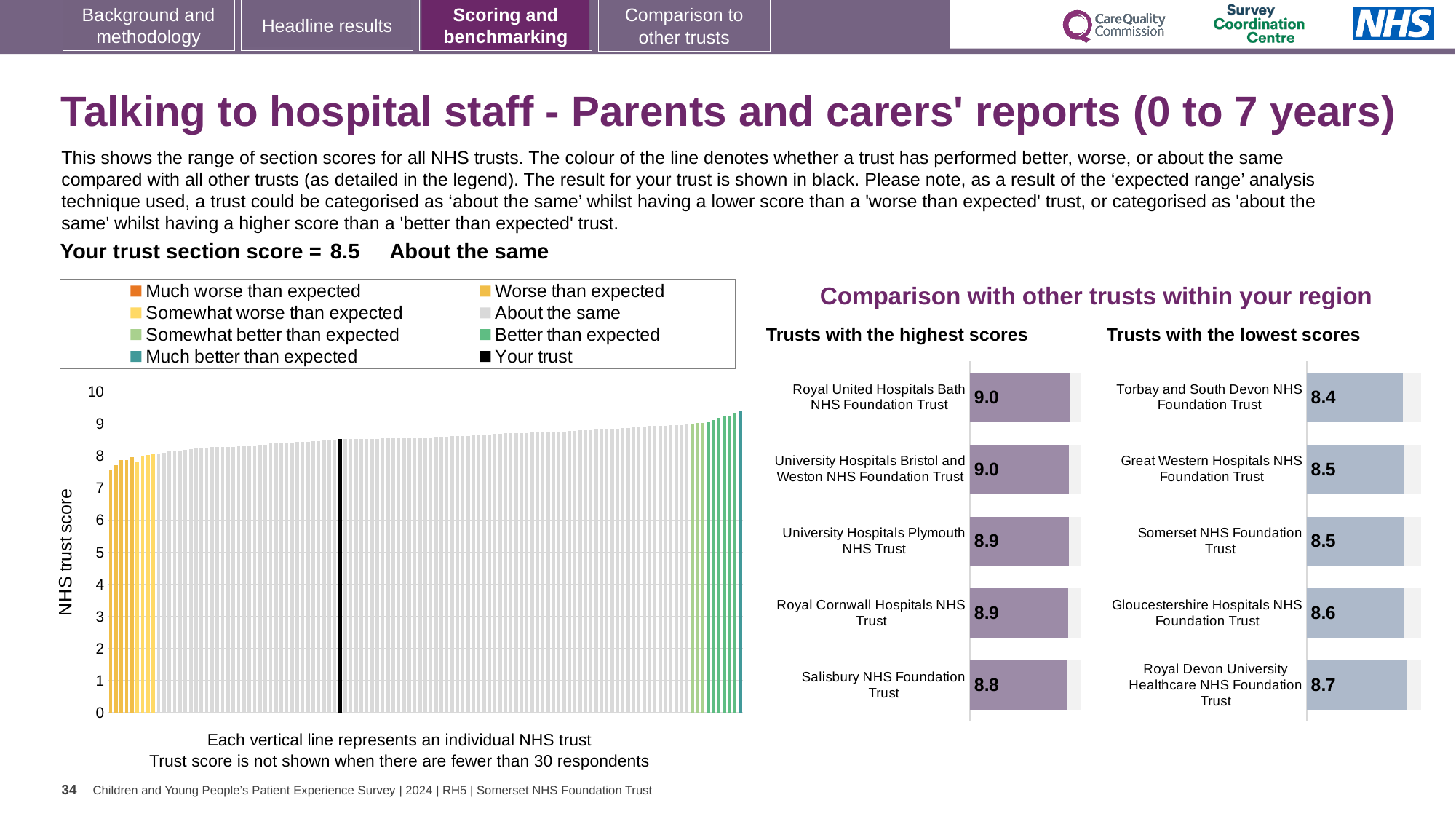
In the large chart on the left, do the trust scores rise or fall from left to right along the x axis? Rise Which is larger: the score for Salisbury NHS Foundation Trust in the highest scores chart, or the score for Royal Devon University Healthcare NHS Foundation Trust in the lowest scores chart? Salisbury NHS Foundation Trust How many entries does the legend of the large chart on the left list? 8 In the 'Trusts with the lowest scores' chart, what is the difference between the score for Royal Devon University Healthcare NHS Foundation Trust and the score for Torbay and South Devon NHS Foundation Trust? 0.3 In the 'Trusts with the lowest scores' chart, which trust has the highest score? Royal Devon University Healthcare NHS Foundation Trust How many trusts are shown in the 'Trusts with the highest scores' chart? 5 In the 'Trusts with the highest scores' chart, what is the difference between the score for Royal United Hospitals Bath NHS Foundation Trust and the score for Salisbury NHS Foundation Trust? 0.2 What kind of chart is the large chart on the left showing NHS trust scores? Bar chart In the 'Trusts with the lowest scores' chart, what is the score for Gloucestershire Hospitals NHS Foundation Trust? 8.6 In the 'Trusts with the lowest scores' chart, which trust has the lowest score? Torbay and South Devon NHS Foundation Trust In the 'Trusts with the highest scores' chart, what is the score for University Hospitals Plymouth NHS Trust? 8.9 In the 'Trusts with the highest scores' chart, what is the score for Salisbury NHS Foundation Trust? 8.8